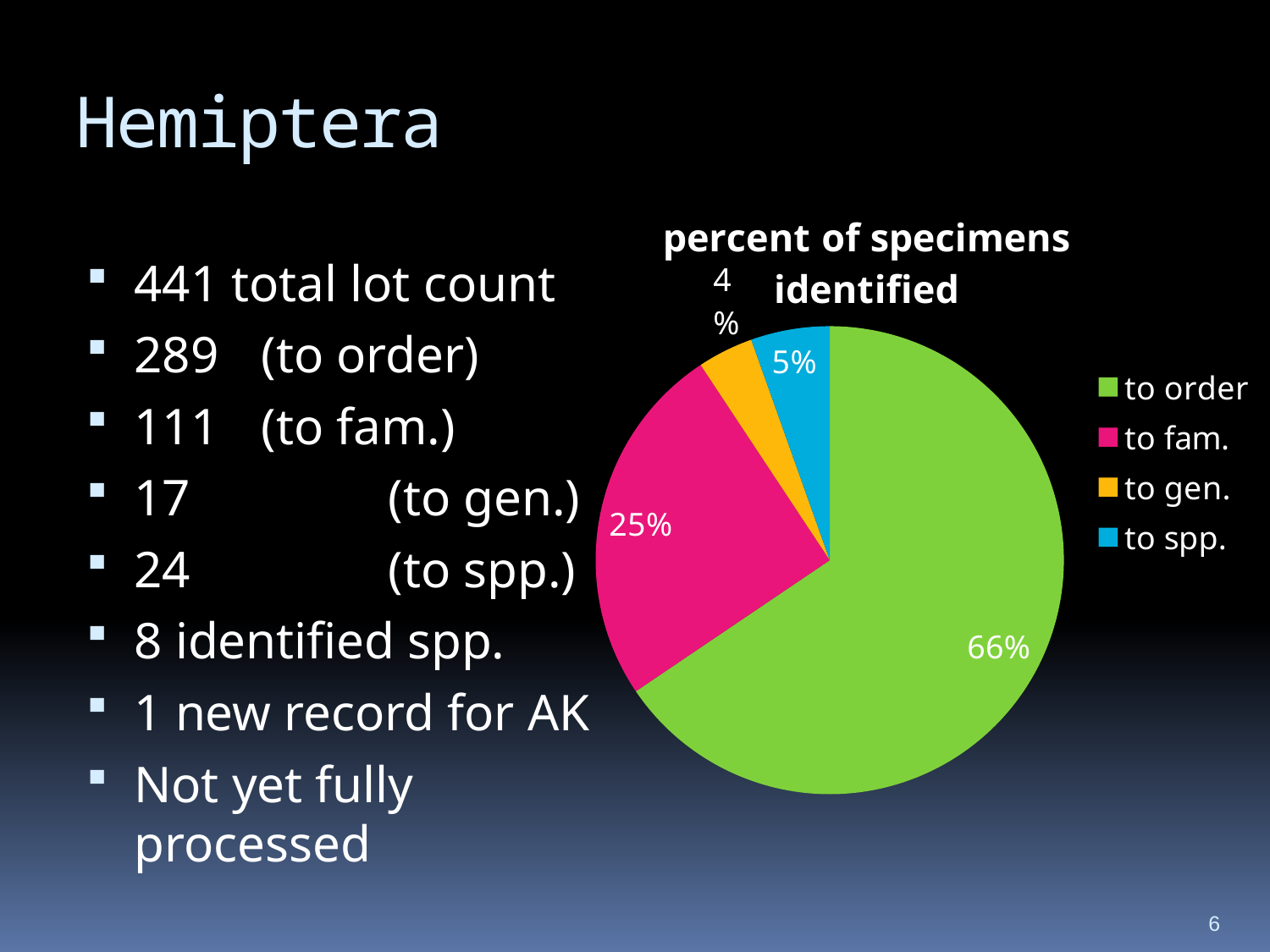
What percentage of specimens were identified to fam.? 25% What percentage of specimens were identified to order? 66% Which category has the smallest share of the pie? to gen. What is the title of the chart? percent of specimens identified What percentage of specimens were identified to spp.? 5% What percentage of specimens were identified to gen.? 4% How many entries does the legend list? 4 Which category has the largest share of the pie? to order What is the difference in percentage points between the 'to order' and 'to fam.' slices? 41 What type of chart is shown on the slide? pie chart Which colour represents 'to fam.' in the pie chart? pink How many slices does the pie chart have? 4